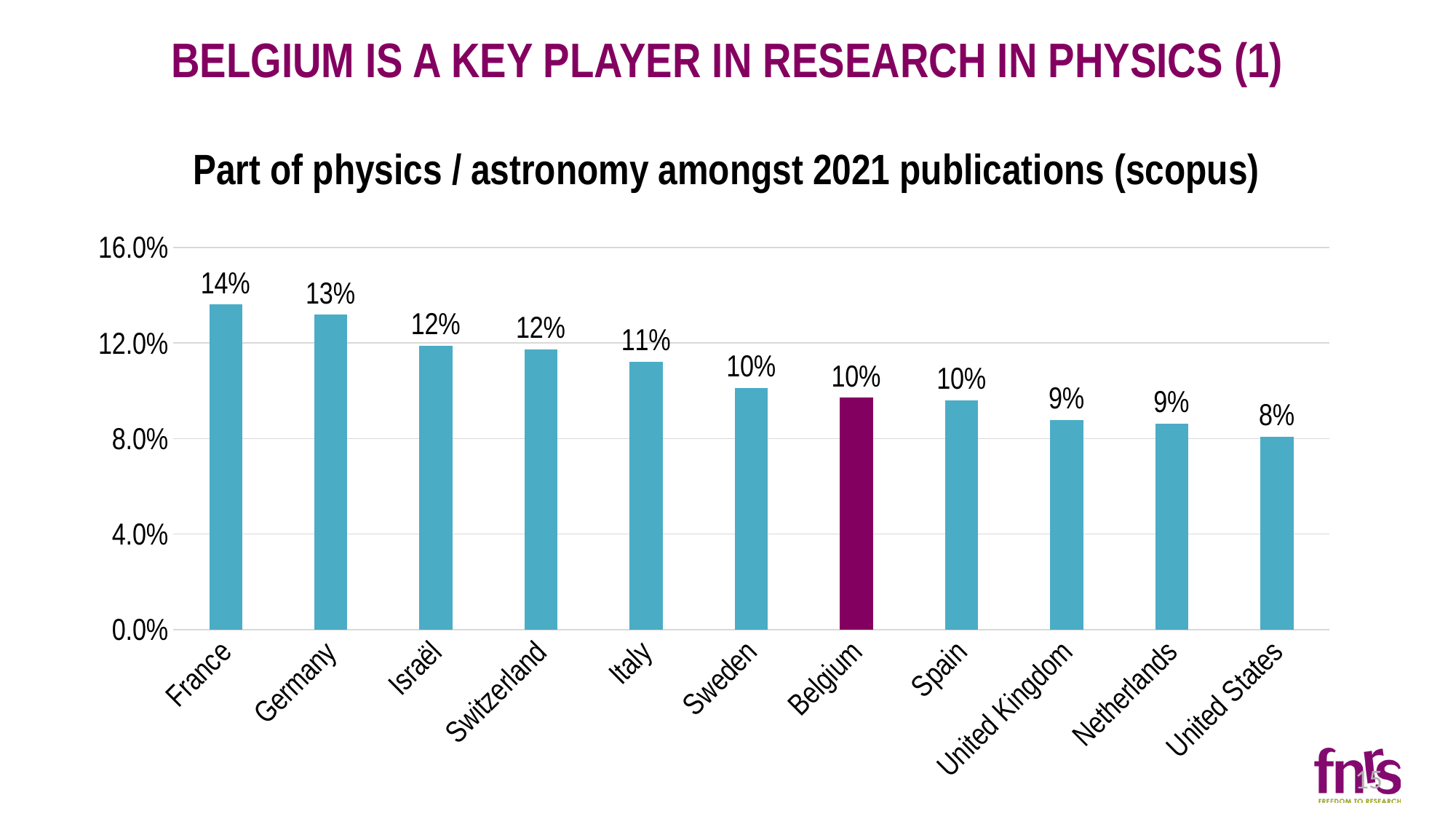
What is the title of the chart? Part of physics / astronomy amongst 2021 publications (scopus) How many countries are shown in the chart? 11 Do the values rise or fall from left to right along the x axis? fall What is the value for the United Kingdom? 9% Which country has the lowest value? United States What is the difference between the values for France and the United States? 6% Which has a larger value, Germany or Italy? Germany What is the value for Belgium? 10% What is the value for France? 14% Is the value for Belgium greater or less than 8.0%? greater What type of chart is shown on the slide? bar chart Which country has the highest value? France